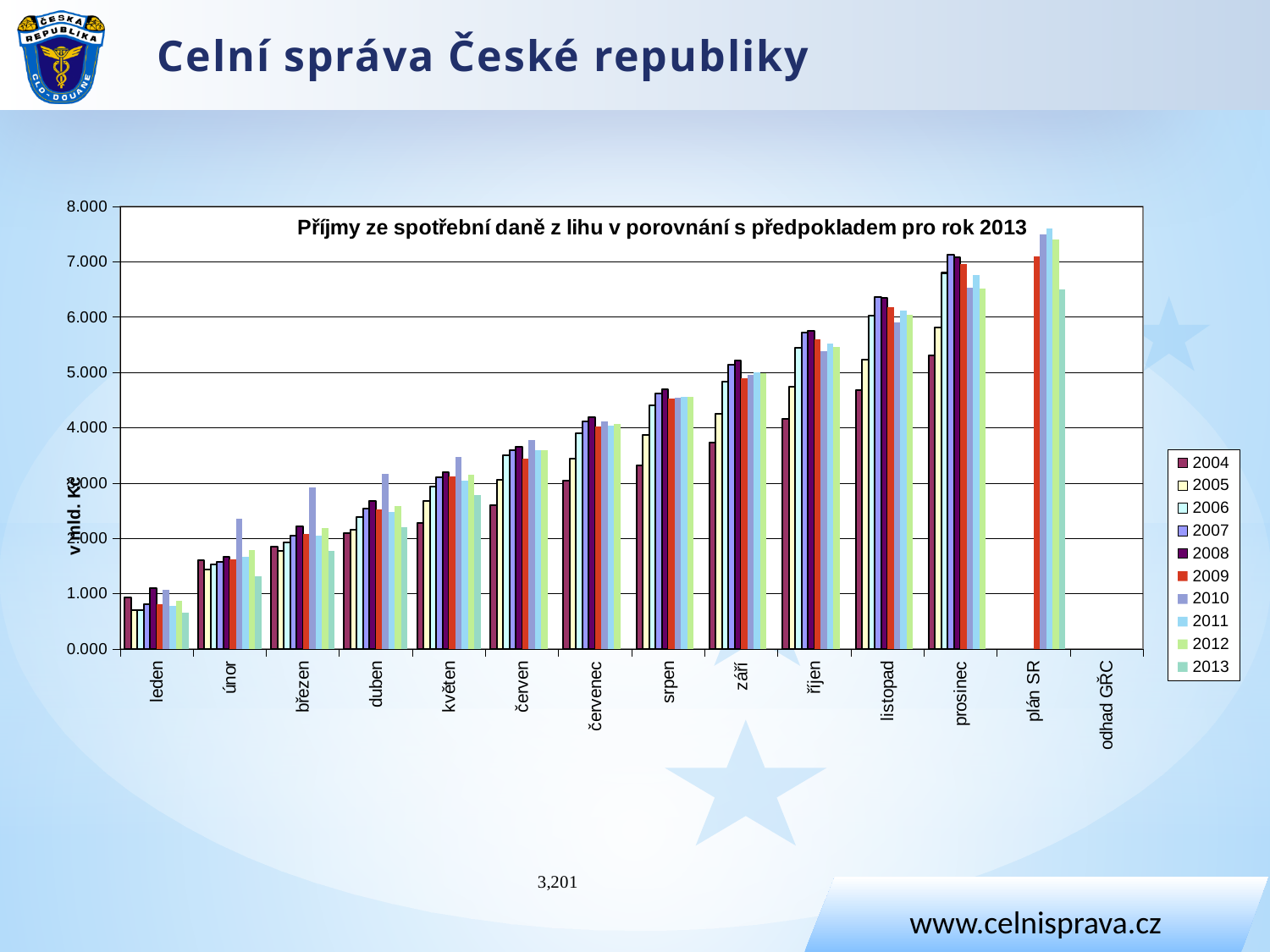
What is the title of the chart? Příjmy ze spotřební daně z lihu v porovnání s předpokladem pro rok 2013 Which series has the lowest value in únor? 2013 What kind of chart is shown on the slide? bar chart Is the value for 2011 in plán SR greater or less than 7.000? greater How many series does the legend list? 10 Is the value for 2004 in leden greater or less than 1.000? less Is the value for 2013 in plán SR greater or less than 7.000? less Which series has the highest value in únor? 2010 What is the label of the vertical axis? v mld. Kč How many categories are shown along the x axis? 14